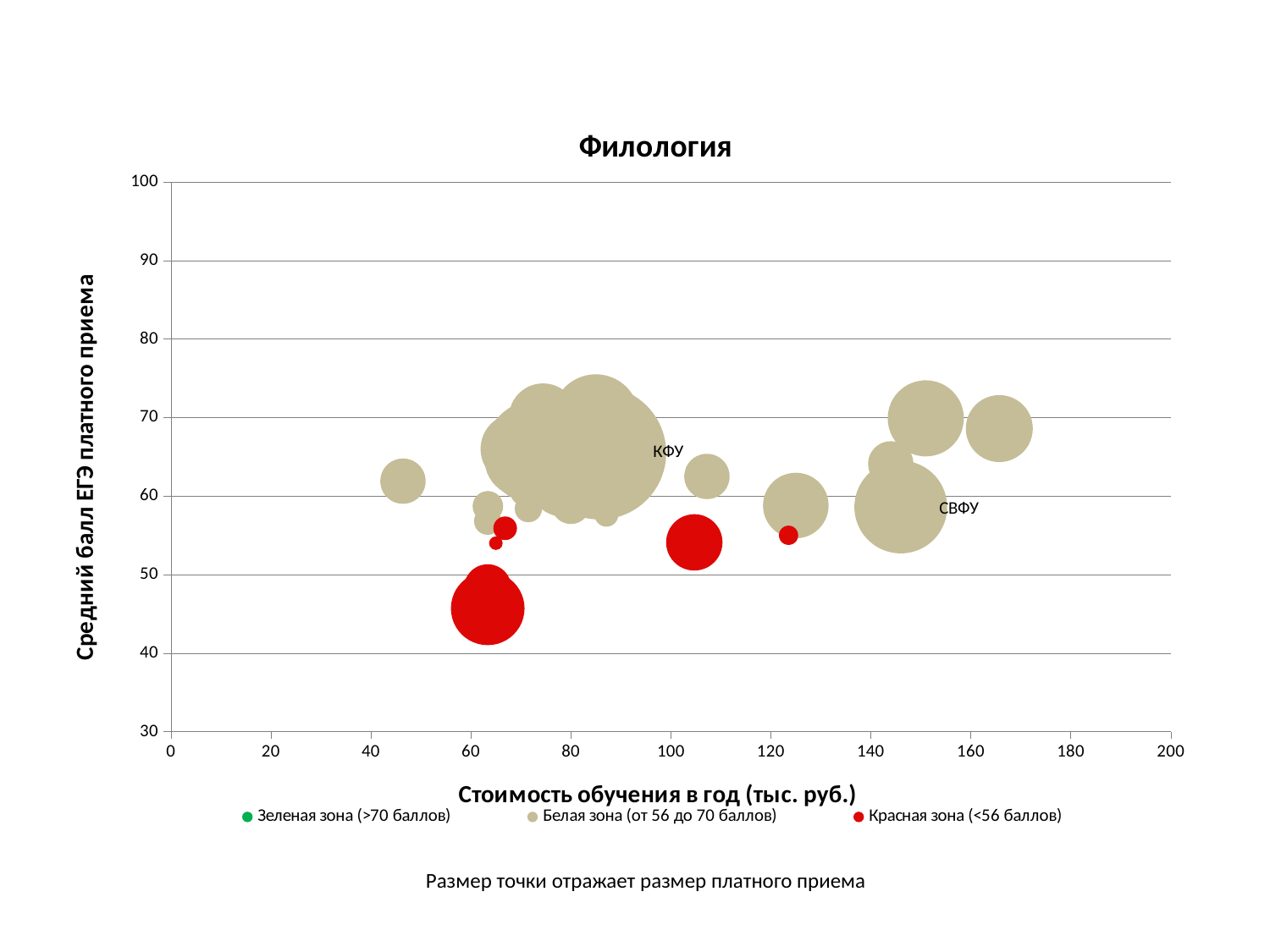
Which labeled university has the higher tuition cost, КФУ or СВФУ? СВФУ Is the tuition cost (x value) for СВФУ greater or less than 120? greater Which labeled university has the higher average exam score, КФУ or СВФУ? КФУ What kind of chart is shown on the slide? bubble chart Is the average exam score (y value) for СВФУ greater or less than 70? less Is the average exam score (y value) for КФУ greater or less than 60? greater What is the title of the chart? Филология What is the label of the x axis? Стоимость обучения в год (тыс. руб.) How many series does the legend list? 3